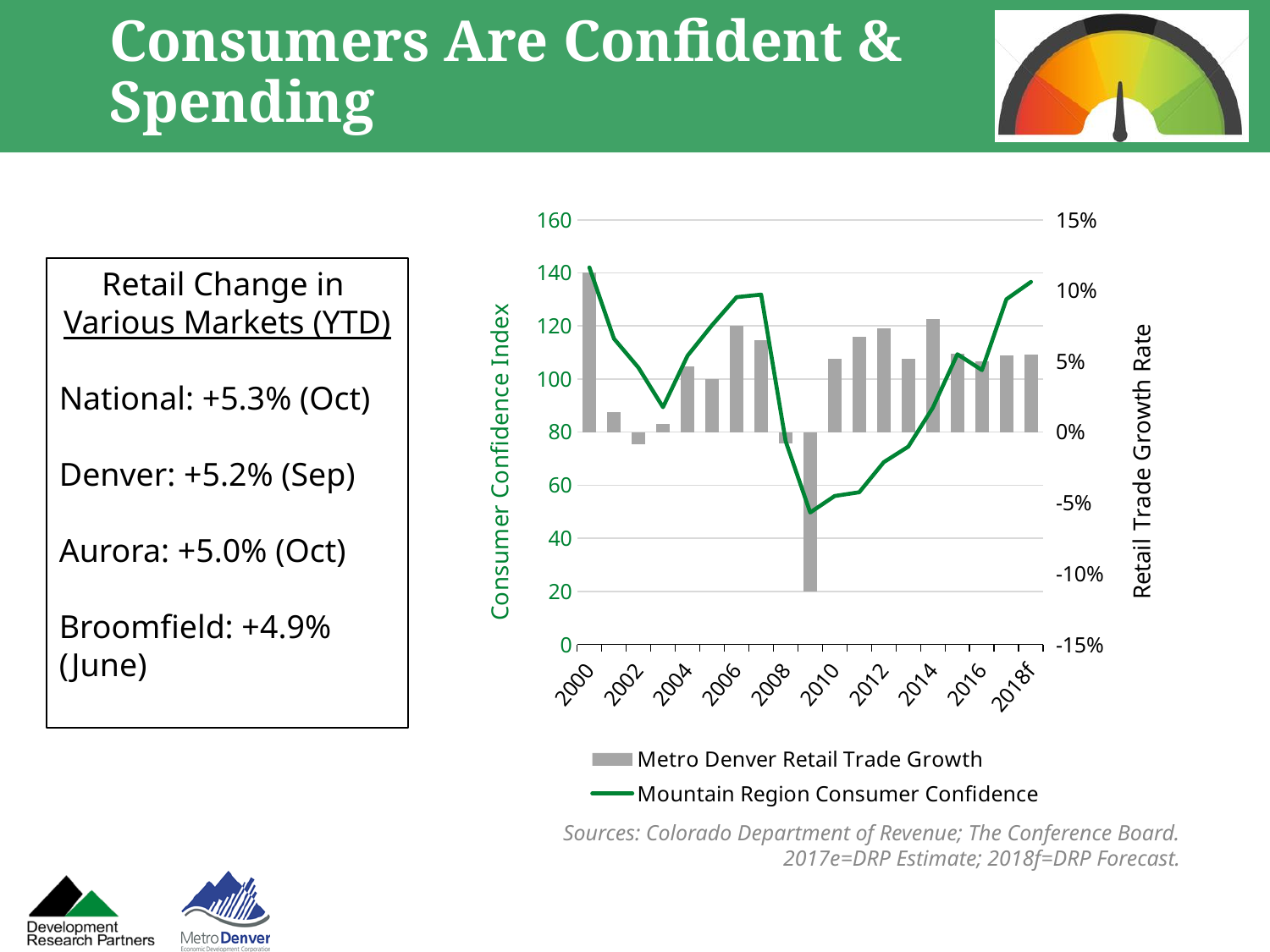
Which year has the larger Metro Denver Retail Trade Growth bar, 2009 or 2010? 2010 How many series does the chart legend list? 2 In which year is the Metro Denver Retail Trade Growth bar highest? 2000 Is the Mountain Region Consumer Confidence value for 2018f greater or less than 120? greater Is the Mountain Region Consumer Confidence value for 2009 greater or less than 60? less Does Mountain Region Consumer Confidence generally rise or fall from 2009 to 2018f? rise What kind of chart is shown on the slide? A combined bar and line chart In which year is the Metro Denver Retail Trade Growth bar lowest? 2009 Which series is drawn as bars in the chart? Metro Denver Retail Trade Growth What is the title of the left vertical axis? Consumer Confidence Index Is the Metro Denver Retail Trade Growth value for 2000 greater or less than 5%? greater